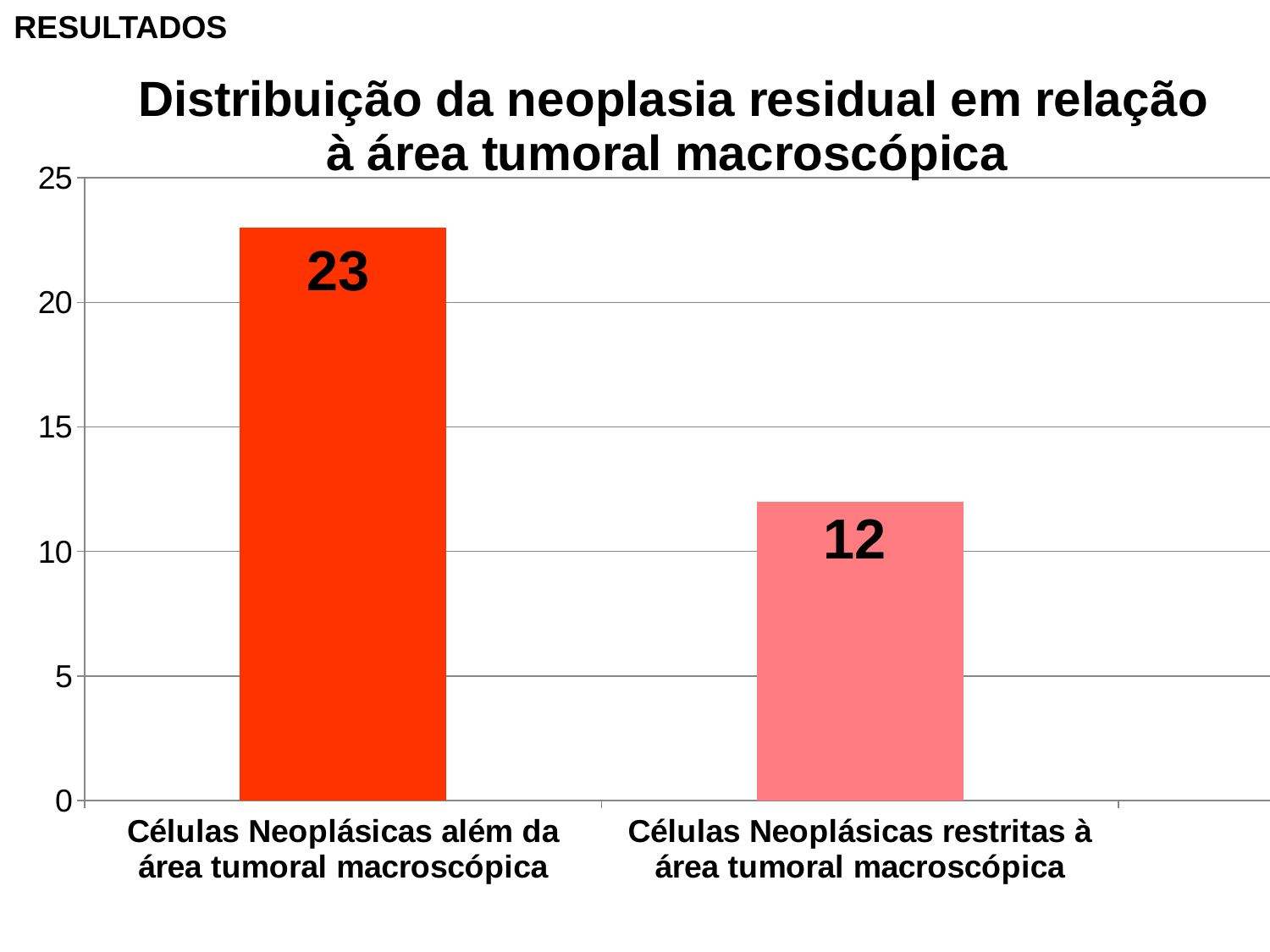
What kind of chart is shown on the slide? bar chart What is the value for "Células Neoplásicas além da área tumoral macroscópica"? 23 Which is larger: the value for "Células Neoplásicas além da área tumoral macroscópica" or for "Células Neoplásicas restritas à área tumoral macroscópica"? Células Neoplásicas além da área tumoral macroscópica Which category has the lowest value? Células Neoplásicas restritas à área tumoral macroscópica How many categories are shown in the chart? 2 Is the value for "Células Neoplásicas além da área tumoral macroscópica" greater or less than 20? greater Is the value for "Células Neoplásicas restritas à área tumoral macroscópica" greater or less than 15? less What is the title of the chart? Distribuição da neoplasia residual em relação à área tumoral macroscópica What is the highest value shown on the vertical axis? 25 What is the difference between the values for "Células Neoplásicas além da área tumoral macroscópica" and "Células Neoplásicas restritas à área tumoral macroscópica"? 11 What is the value for "Células Neoplásicas restritas à área tumoral macroscópica"? 12 Which category has the highest value? Células Neoplásicas além da área tumoral macroscópica